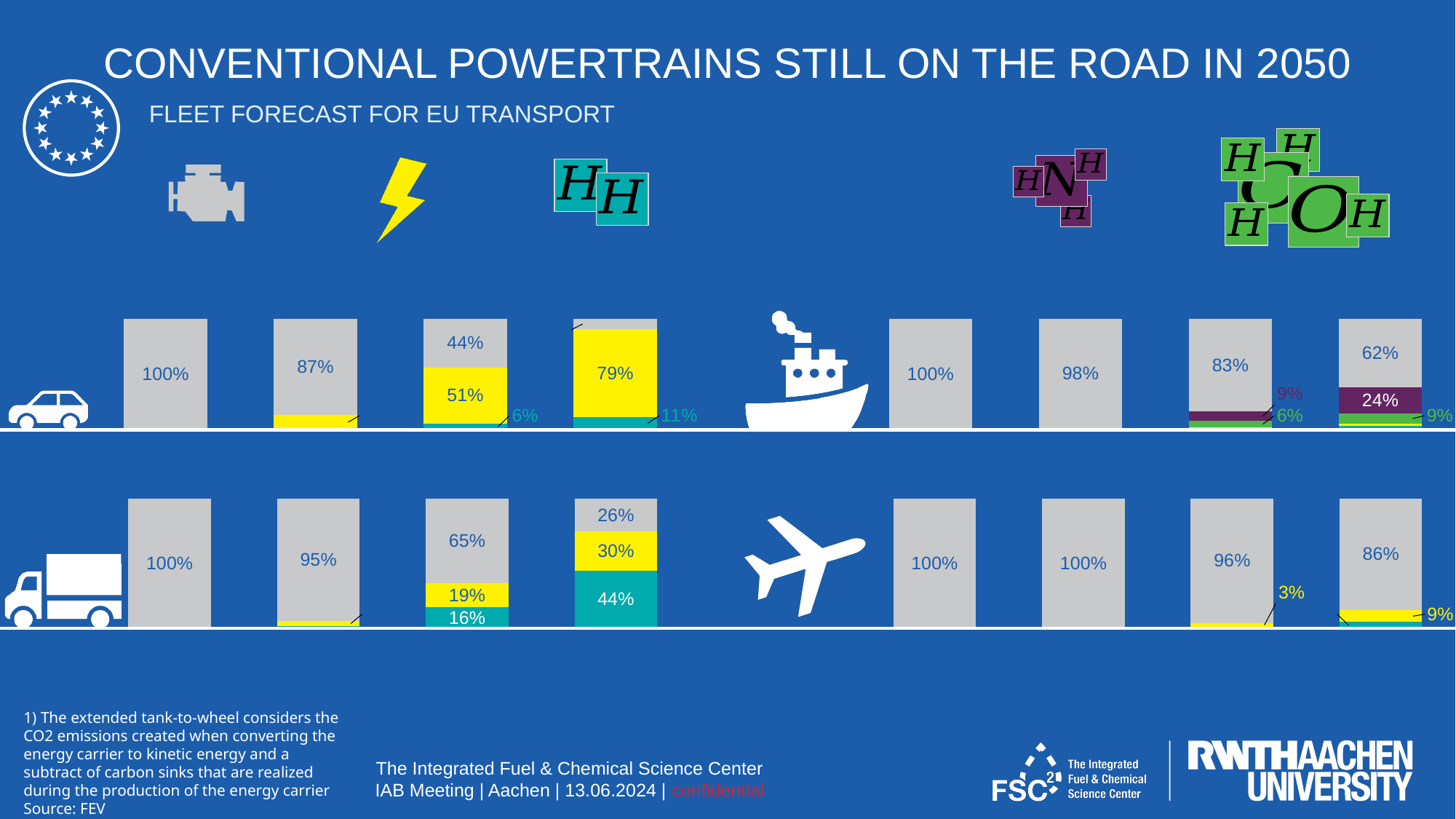
In the passenger car chart (top left), what is the value of the grey segment in the first bar? 100% In the ship chart (top right), what is the value of the purple segment in the fourth bar? 24% In the airplane chart (bottom right), what is the value of the grey segment in the fourth bar? 86% How many bars does the truck chart (bottom left) contain? 4 In the truck chart (bottom left), what is the value of the teal segment in the fourth bar? 44% In the passenger car chart (top left), what is the value of the yellow segment in the third bar? 51% In the passenger car chart (top left), what is the value of the yellow segment in the fourth bar? 79% In the ship chart (top right), what is the value of the grey segment in the third bar? 83% In the airplane chart (bottom right), which is larger: the yellow segment of the third bar or the yellow segment of the fourth bar? the fourth bar (9%) In the ship chart (top right), does the grey segment rise or fall from the first bar to the fourth bar? fall What kind of chart is used for the passenger car fleet forecast? stacked bar chart In the truck chart (bottom left), what is the difference between the grey segment of the third bar and the grey segment of the fourth bar? 39%